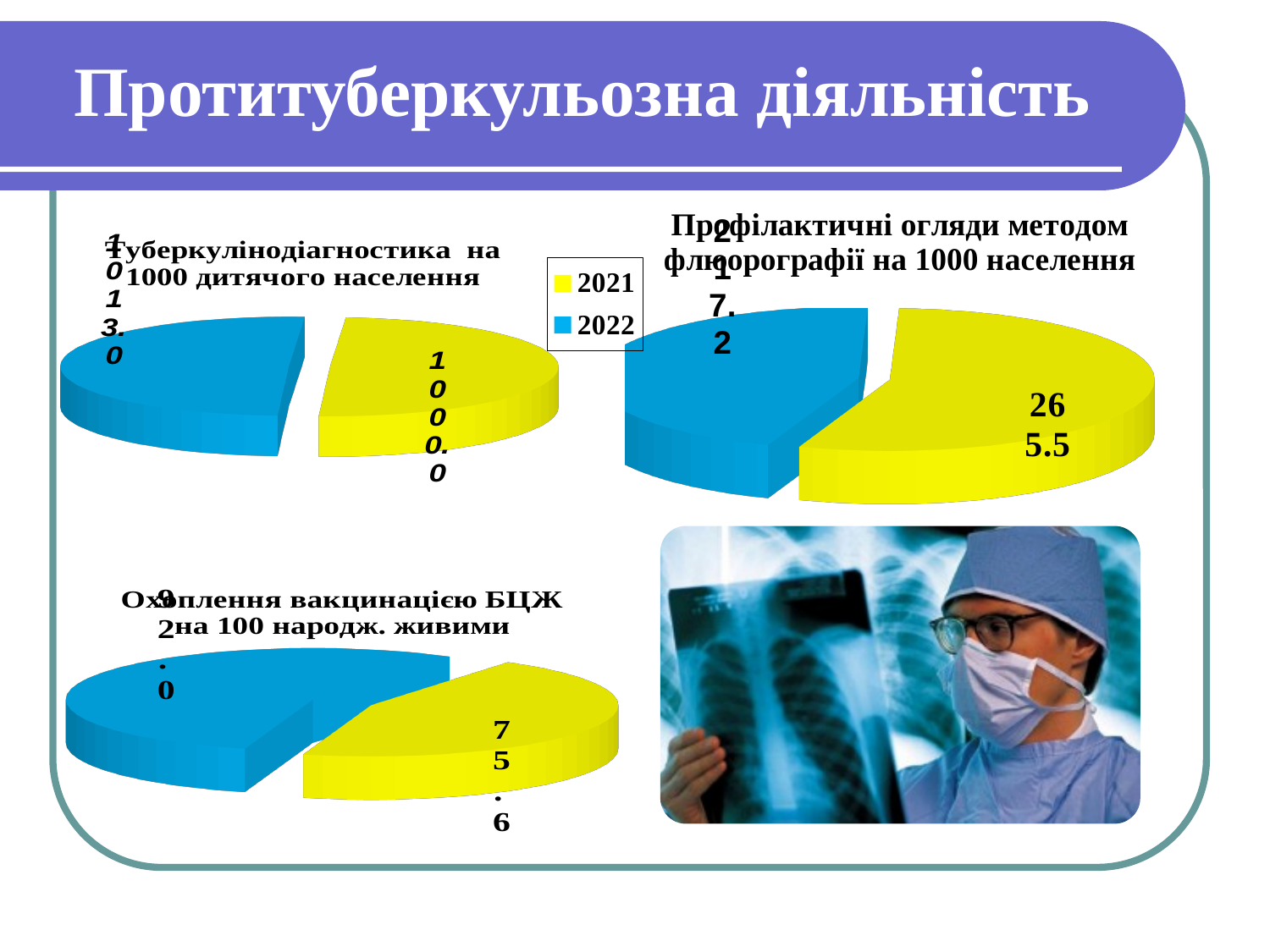
In the chart "Профілактичні огляди методом флюорографії на 1000 населення", what is the value for 2022? 217.2 In the chart "Профілактичні огляди методом флюорографії на 1000 населення", what is the value for 2021? 265.5 In the chart "Профілактичні огляди методом флюорографії на 1000 населення", what is the difference between the 2021 and 2022 values? 48.3 How many series does the legend on the slide list? 2 In the chart "Профілактичні огляди методом флюорографії на 1000 населення", which year has the higher value? 2021 What type of chart is used for "Туберкулінодіагностика на 1000 дитячого населення"? Pie chart In the chart "Туберкулінодіагностика на 1000 дитячого населення", what is the value for 2022? 1013.0 In the chart "Туберкулінодіагностика на 1000 дитячого населення", what is the value for 2021? 1000.0